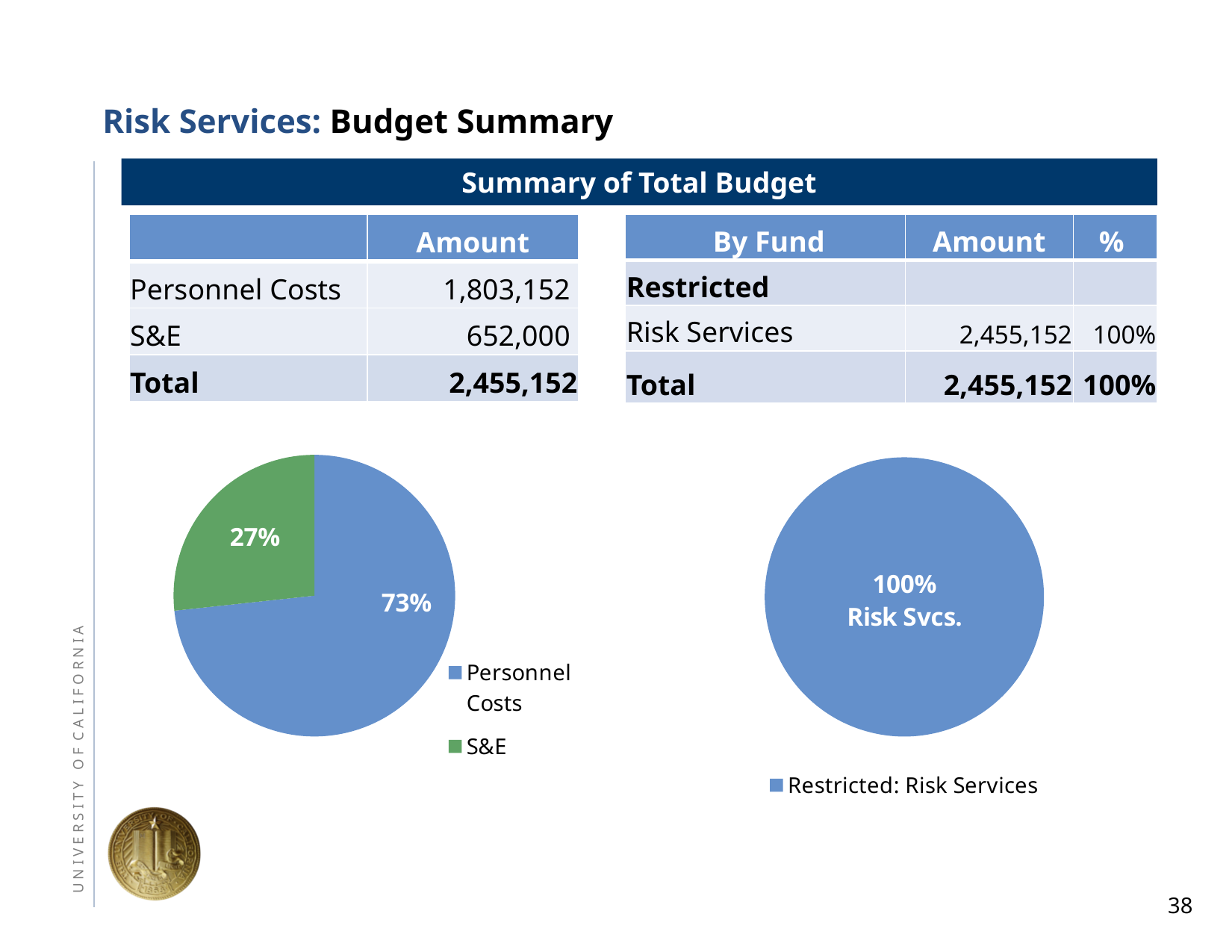
In the left pie chart, what is the difference in percentage points between the Personnel Costs slice and the S&E slice? 46 In the left pie chart, which slice is the largest? Personnel Costs In the left pie chart, what share is labelled for Personnel Costs? 73% What kind of chart is the chart on the left of the slide? Pie chart In the left pie chart, what colour is the S&E slice? Green What is the legend entry of the right pie chart? Restricted: Risk Services In the right pie chart, what share is labelled for Risk Svcs.? 100% In the left pie chart, what share is labelled for S&E? 27% How many entries does the legend of the right pie chart list? 1 In the left pie chart, which is larger, Personnel Costs or S&E? Personnel Costs In the left pie chart, which slice is the smallest? S&E How many slices does the left pie chart have? 2